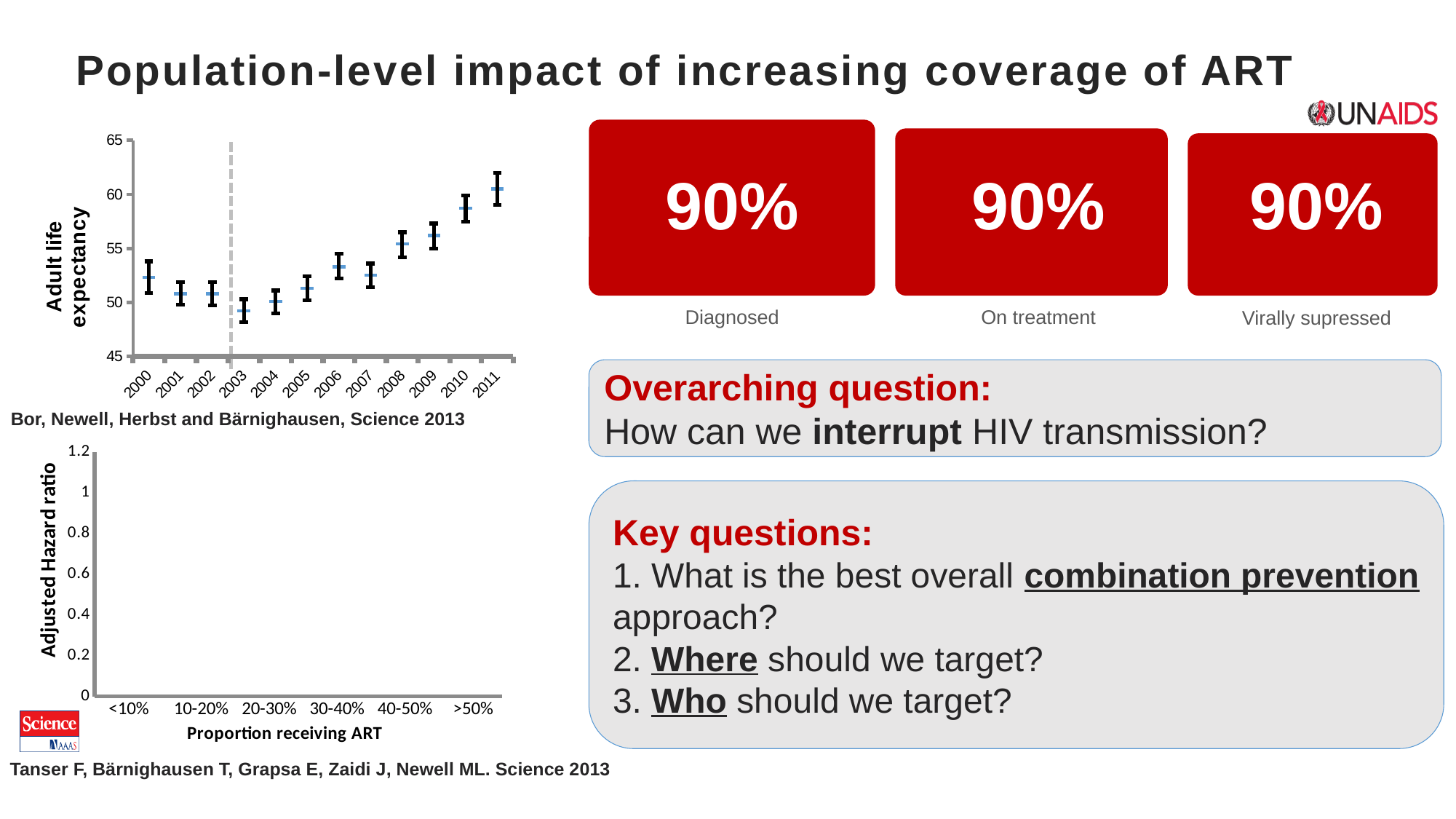
In the top-left chart, is the adult life expectancy for 2010 greater or less than 55? greater In the top-left chart, is the adult life expectancy for 2011 greater or less than 55? greater In the bottom-left chart, how many categories are shown on the x axis? 6 In the top-left chart, what is the label on the y axis? Adult life expectancy In the top-left chart, which is larger, the adult life expectancy for 2009 or for 2002? 2009 In the top-left chart, which year has the highest adult life expectancy? 2011 In the top-left chart, do the adult life expectancy values rise or fall from 2003 to 2011? rise In the top-left chart, is the adult life expectancy for 2000 greater or less than 55? less In the bottom-left chart, what is the label on the x axis? Proportion receiving ART In the top-left chart, how many years are shown on the x axis? 12